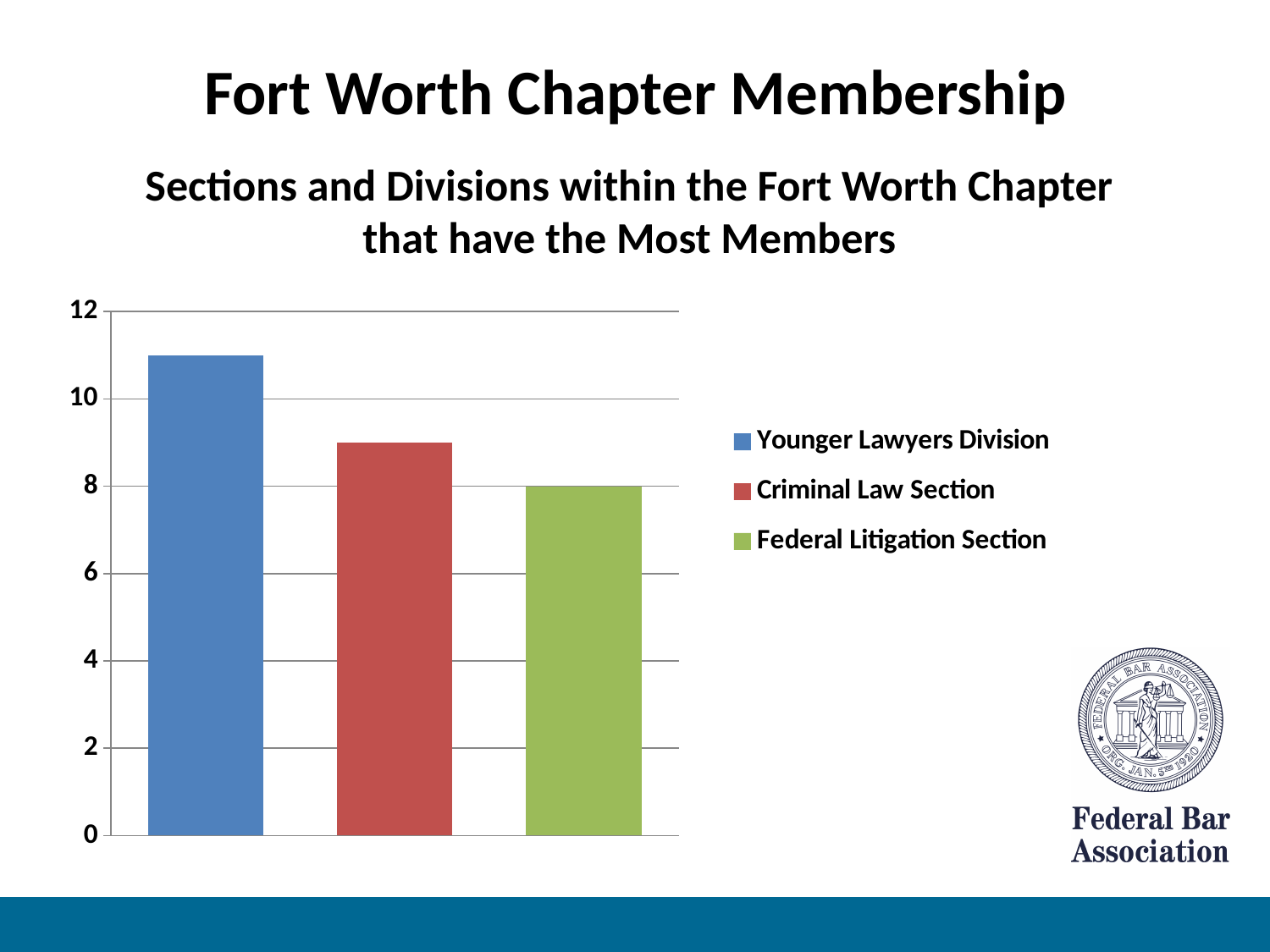
Is the value for the Criminal Law Section greater or less than 10? less What is the value for the Federal Litigation Section? 8 How many bars are plotted in the chart? 3 Is the value for the Criminal Law Section greater or less than 8? greater What type of chart is shown on the slide? bar chart How many entries does the chart's legend list? 3 Which section or division has the highest value in the chart? Younger Lawyers Division Which is larger, the value for the Younger Lawyers Division or the value for the Criminal Law Section? Younger Lawyers Division What colour is the bar for the Criminal Law Section? red Which section or division has the lowest value in the chart? Federal Litigation Section Do the bar values rise or fall from left to right across the chart? fall Is the value for the Younger Lawyers Division greater or less than 10? greater